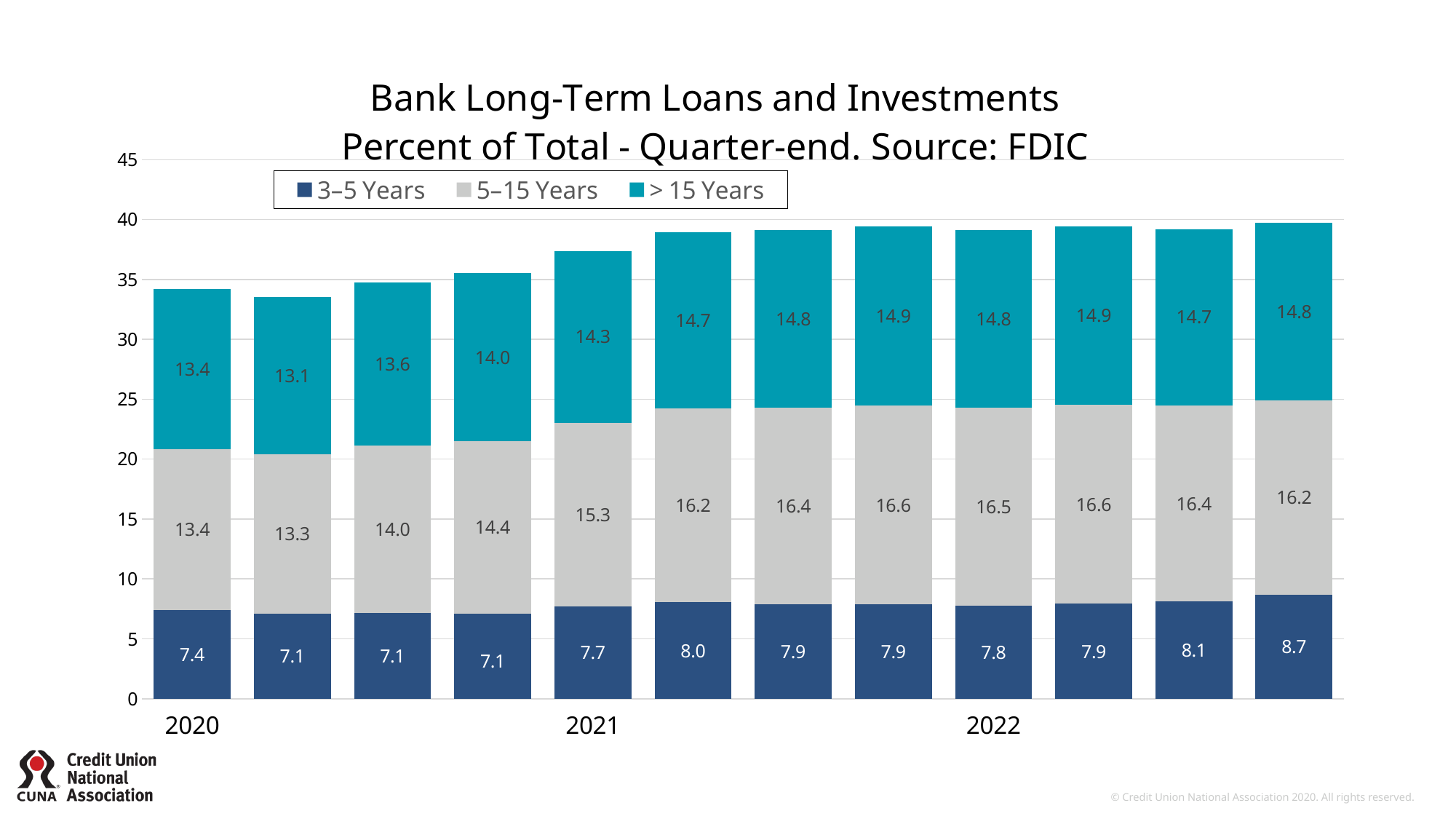
What is the value of the 3–5 Years segment in the bar labeled 2020? 7.4 What is the value of the > 15 Years segment in the bar labeled 2021? 14.3 Which has the larger > 15 Years segment, the bar labeled 2020 or the bar labeled 2021? 2021 How much larger is the 5–15 Years segment in the bar labeled 2022 than in the bar labeled 2020? 3.1 How many series does the legend list? 3 What is the total of the stacked bar labeled 2020? 34.2 What is the total of the rightmost stacked bar? 39.7 What is the value of the 5–15 Years segment in the bar labeled 2022? 16.5 What kind of chart is shown on the slide? Stacked bar chart Which series has the largest segment in the rightmost bar? 5–15 Years How many stacked bars are plotted in the chart? 12 What is the value of the 3–5 Years segment in the rightmost bar? 8.7